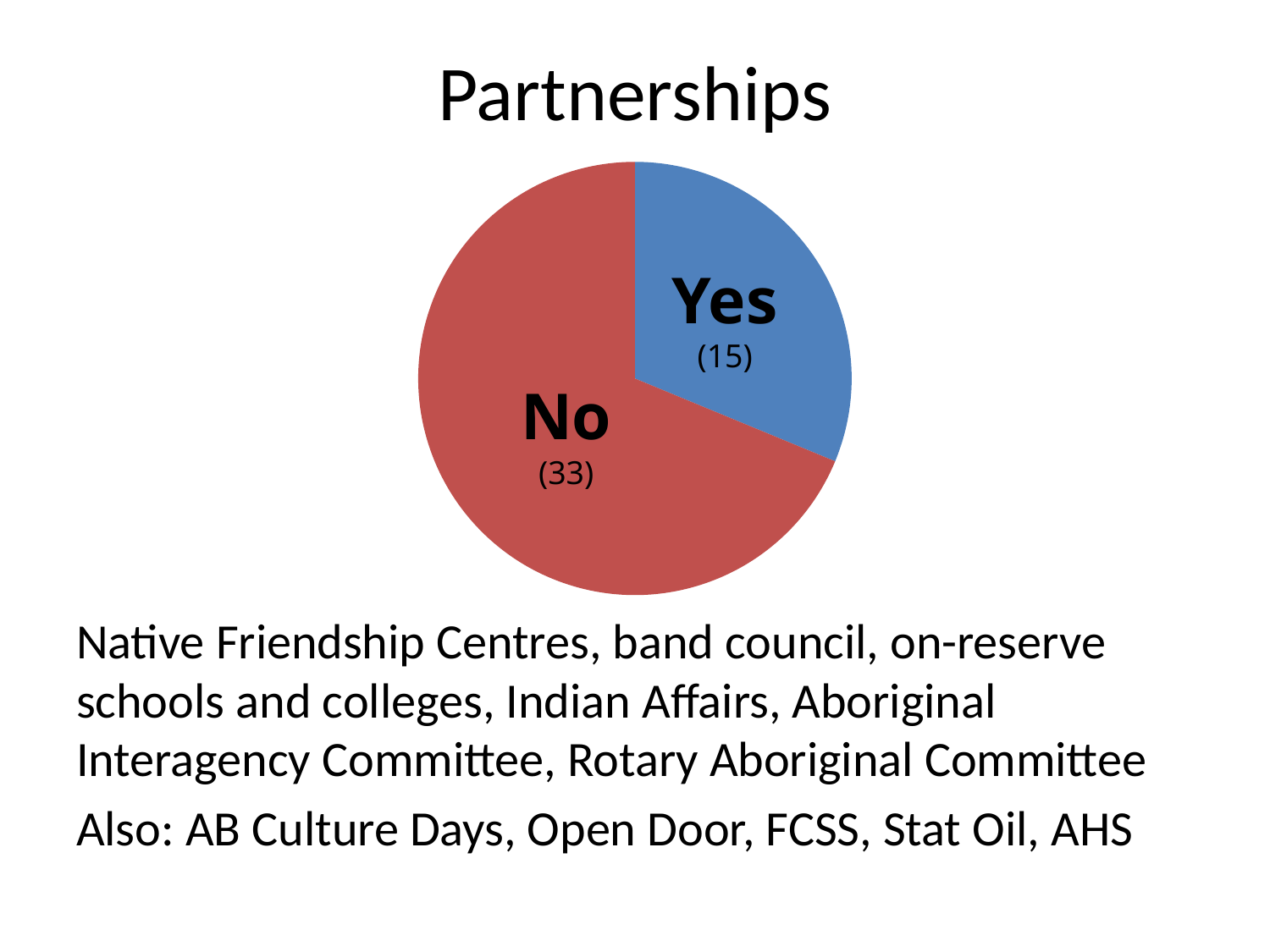
Which is larger, the "Yes" slice or the "No" slice? No What kind of chart is shown on the slide? pie chart Which slice is the largest? No What is the title of the chart? Partnerships What is the total of the two slices? 48 What is the value for the "No" slice? 33 How many slices does the pie chart have? 2 What is the value for the "Yes" slice? 15 What colour is the "No" slice? red Which slice is the smallest? Yes What is the difference between the "No" and "Yes" values? 18